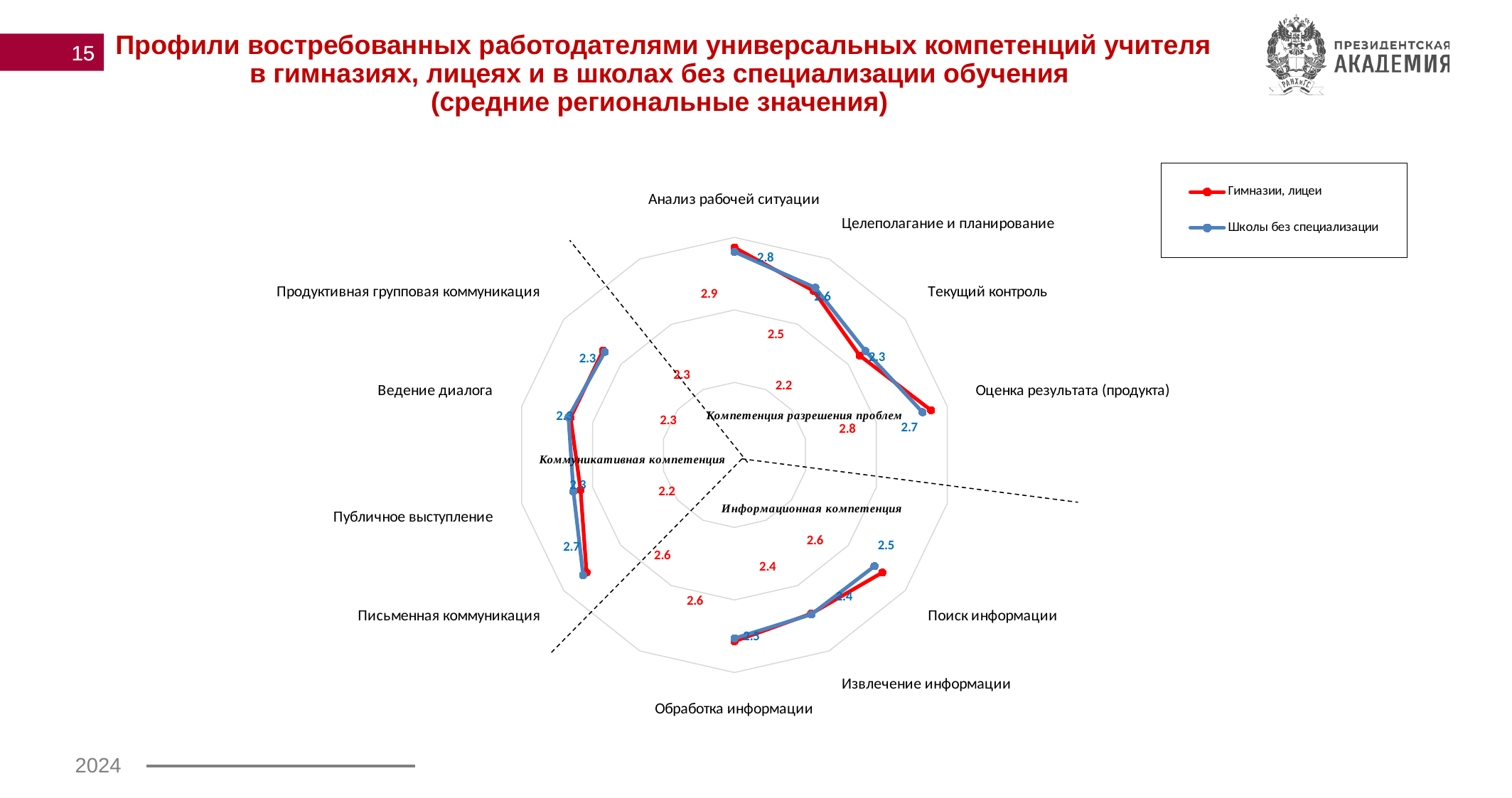
What is the value for Письменная коммуникация in the Школы без специализации series? 2.7 In the Школы без специализации series, which is larger: Оценка результата (продукта) or Извлечение информации? Оценка результата (продукта) Which category has the highest value in the Школы без специализации series? Анализ рабочей ситуации What is the difference between Анализ рабочей ситуации and Текущий контроль in the Школы без специализации series? 0.5 How many series does the legend list? 2 What is the value for Оценка результата (продукта) in the Школы без специализации series? 2.7 What colour is used for the Гимназии, лицеи series? Red What is the value for Оценка результата (продукта) in the Гимназии, лицеи series? 2.8 What is the value for Анализ рабочей ситуации in the Гимназии, лицеи series? 2.9 What is the value for Анализ рабочей ситуации in the Школы без специализации series? 2.8 What kind of chart is shown on the slide? Radar chart What is the value for Поиск информации in the Школы без специализации series? 2.5